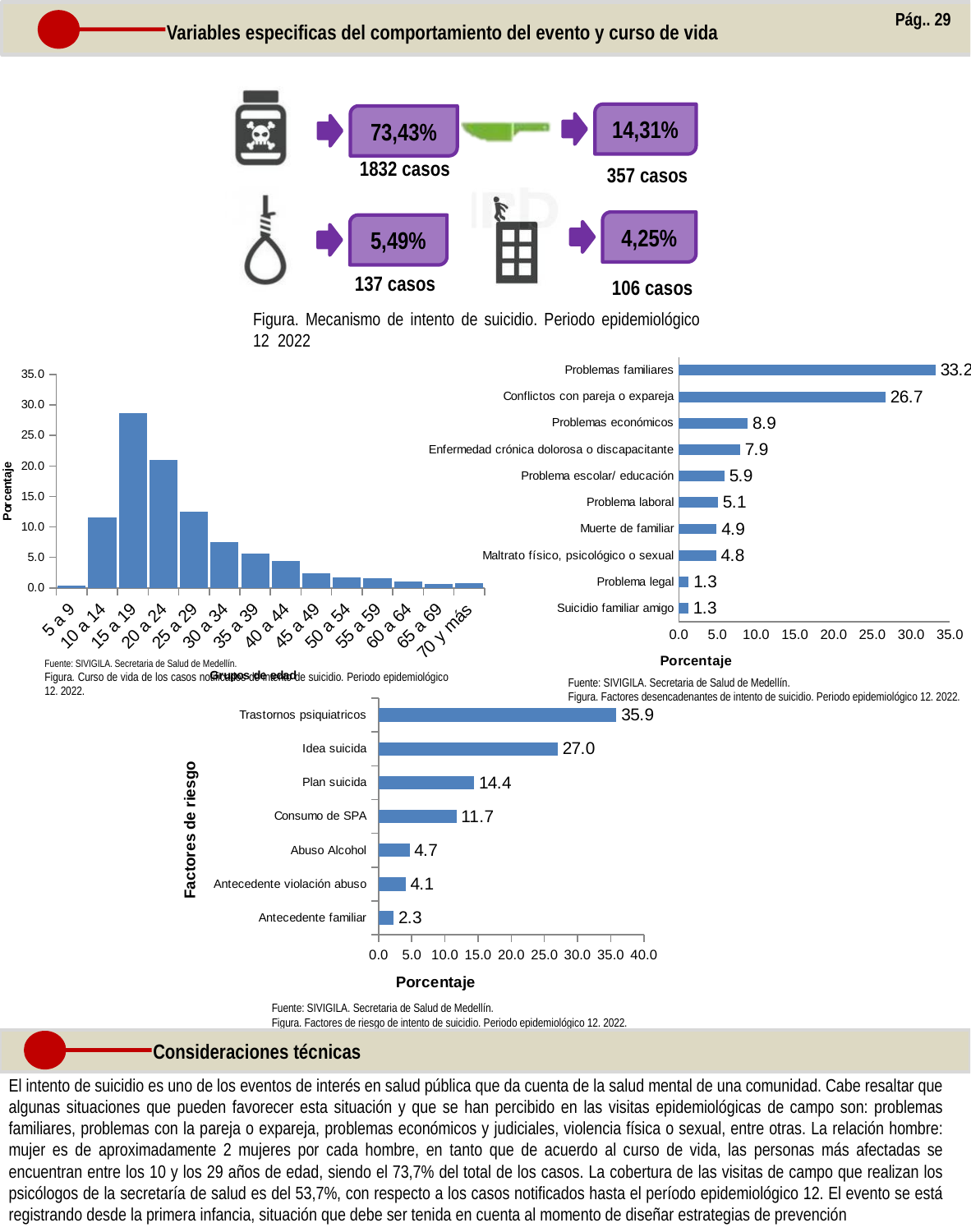
In the age-group chart (Curso de vida, left), which age group has the highest percentage? 15 a 19 In the chart of triggering factors (Factores desencadenantes), what is the difference between Problemas familiares and Conflictos con pareja o expareja? 6.5 In the age-group chart (Curso de vida, left), is the value for 15 a 19 greater or less than 25.0? greater In the chart of risk factors (Factores de riesgo), which category has the lowest value? Antecedente familiar How many categories are shown in the chart of triggering factors (Factores desencadenantes)? 10 In the chart of risk factors (Factores de riesgo), which is larger: Abuso Alcohol or Antecedente violación abuso? Abuso Alcohol In the chart of risk factors (Factores de riesgo), which category has the highest value? Trastornos psiquiatricos In the chart of risk factors (Factores de riesgo), what is the difference between Idea suicida and Plan suicida? 12.6 How many age groups are shown in the age-group chart (Curso de vida, left)? 14 In the chart of risk factors (Factores de riesgo), what is the value for Consumo de SPA? 11.7 In the chart of triggering factors (Factores desencadenantes), what is the value for Problemas familiares? 33.2 In the chart of triggering factors (Factores desencadenantes), what is the value for Problemas económicos? 8.9